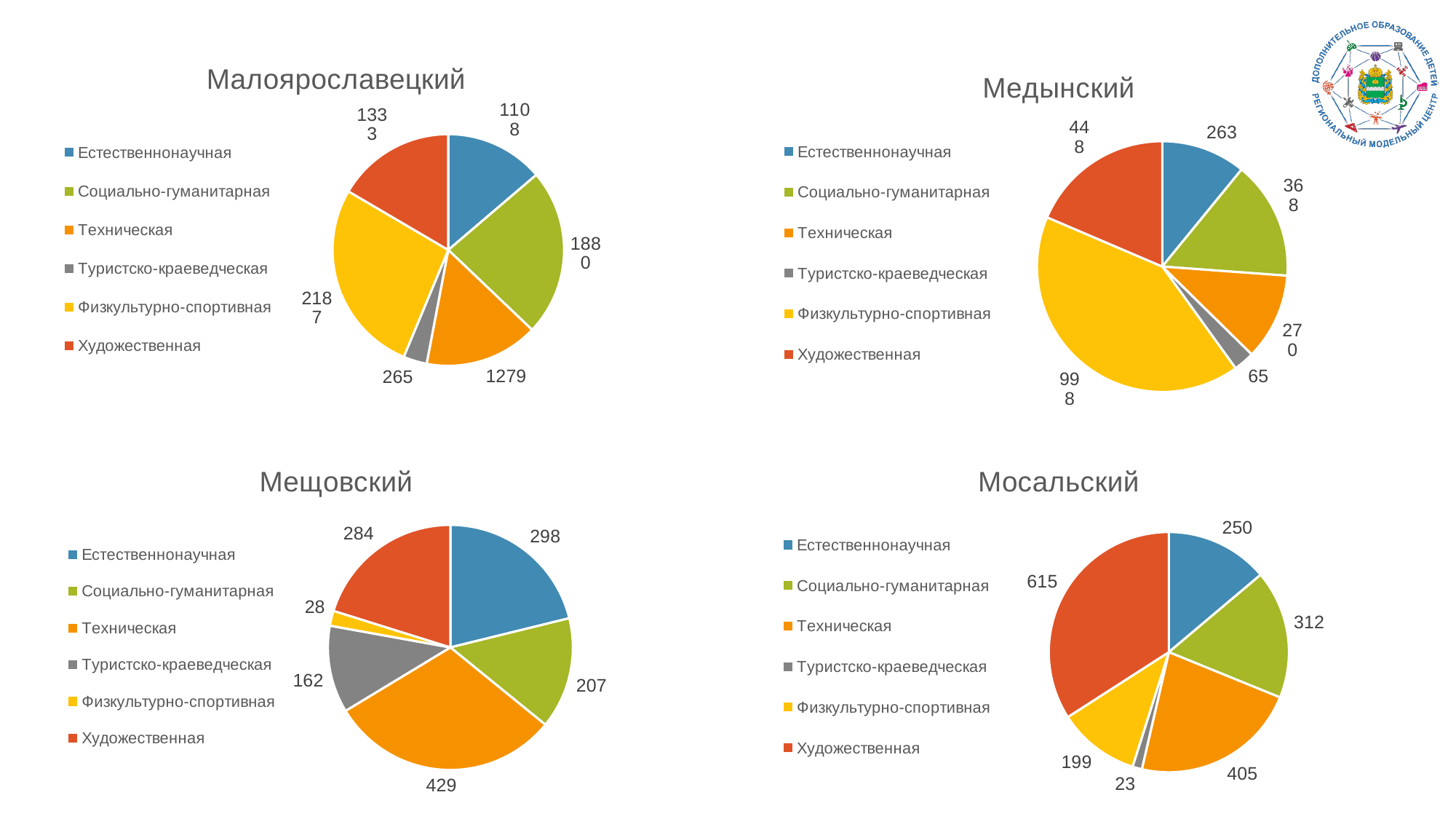
In the Мещовский pie chart, which is larger: Естественнонаучная or Художественная? Естественнонаучная What kind of chart is the Мещовский chart? Pie chart In the Мосальский pie chart, which category has the smallest slice? Туристско-краеведческая How many categories does the Мосальский pie chart show? 6 In the Медынский pie chart, which category has the largest slice? Физкультурно-спортивная In the Мещовский pie chart, what is the value for Техническая? 429 In the Мосальский pie chart, what is the value for Художественная? 615 In the Медынский pie chart, what is the value for Туристско-краеведческая? 65 In the Мещовский pie chart, which category has the smallest slice? Физкультурно-спортивная In the Мосальский pie chart, what is the difference between the values for Техническая and Социально-гуманитарная? 93 In the Мосальский pie chart, which category has the largest slice? Художественная In the Малоярославецкий pie chart, what is the value for Техническая? 1279